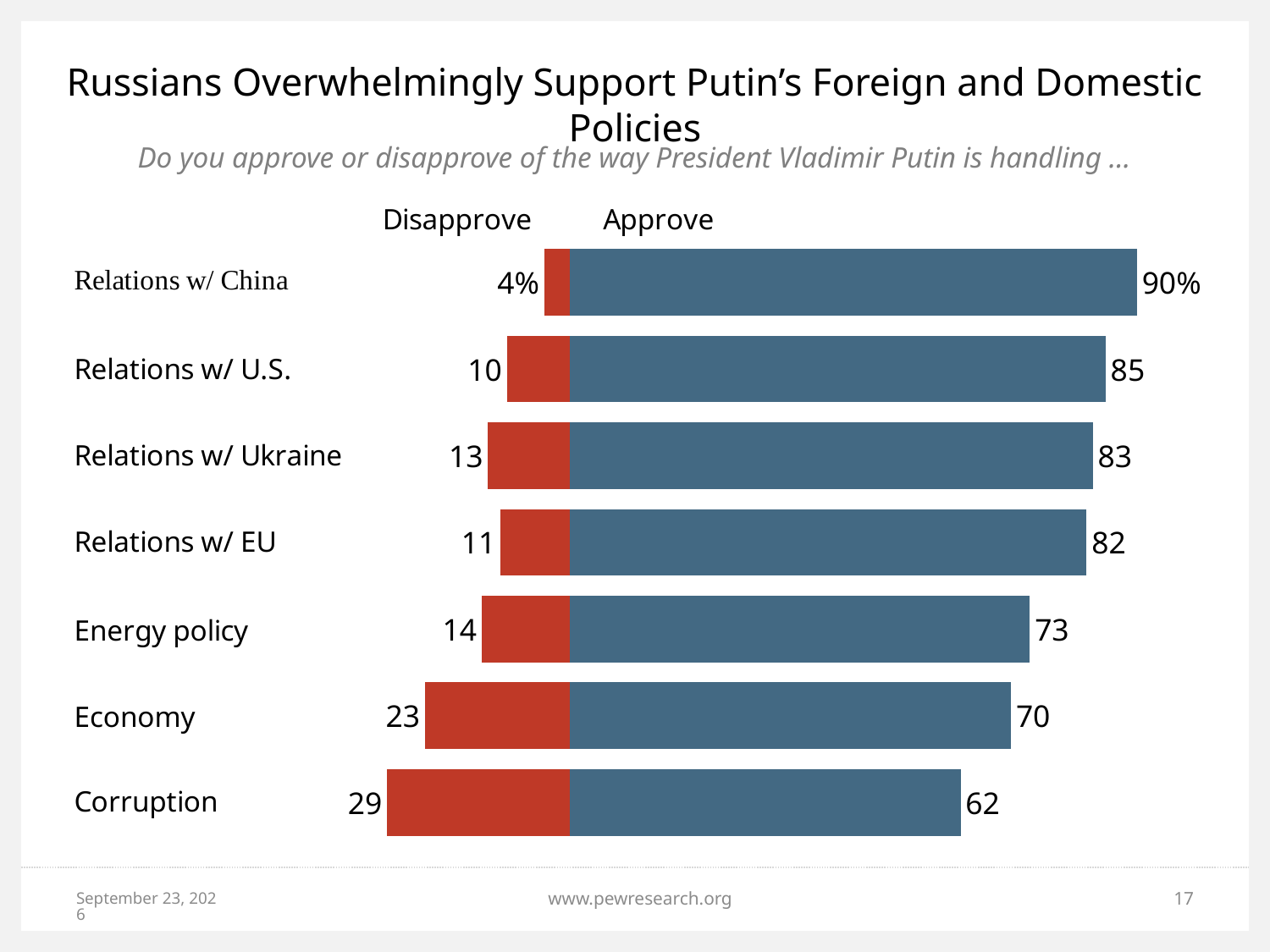
Which category has the lowest Approve value? Corruption Which category has the lowest Disapprove value? Relations w/ China What is the difference between the Approve values for Relations w/ U.S. and Economy? 15 What kind of chart is shown on the slide? Bar chart What is the Disapprove value for Economy? 23 How many categories are shown in the chart? 7 Which is larger, the Disapprove value for Relations w/ Ukraine or for Relations w/ EU? Relations w/ Ukraine What is the Disapprove value for Corruption? 29 What is the Approve value for Energy policy? 73 Which category has the highest Approve value? Relations w/ China What is the Approve value for Relations w/ China? 90% How many series does the chart show? 2